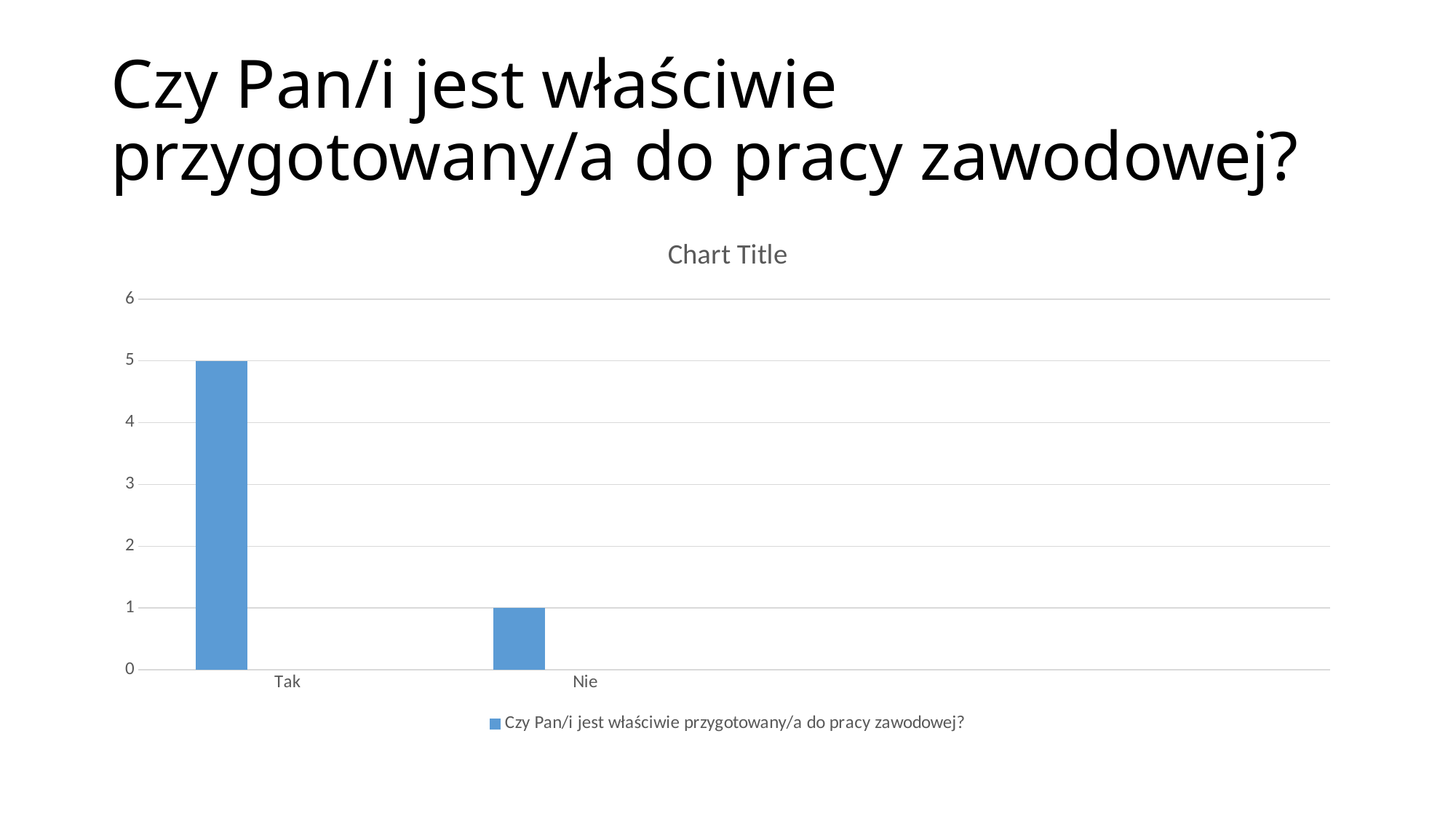
What is the title shown above the chart? Chart Title Which is larger, the value for Tak or the value for Nie? Tak Which category has the highest value? Tak What is the value for Tak? 5 Which category has the lowest value? Nie How many categories are shown on the x axis of the chart? 2 What is the legend entry of the chart? Czy Pan/i jest właściwie przygotowany/a do pracy zawodowej? What kind of chart is shown on the slide? bar chart Is the value for Tak greater or less than 3? greater How many series does the chart legend list? 1 What is the value for Nie? 1 What is the difference between the values for Tak and Nie? 4